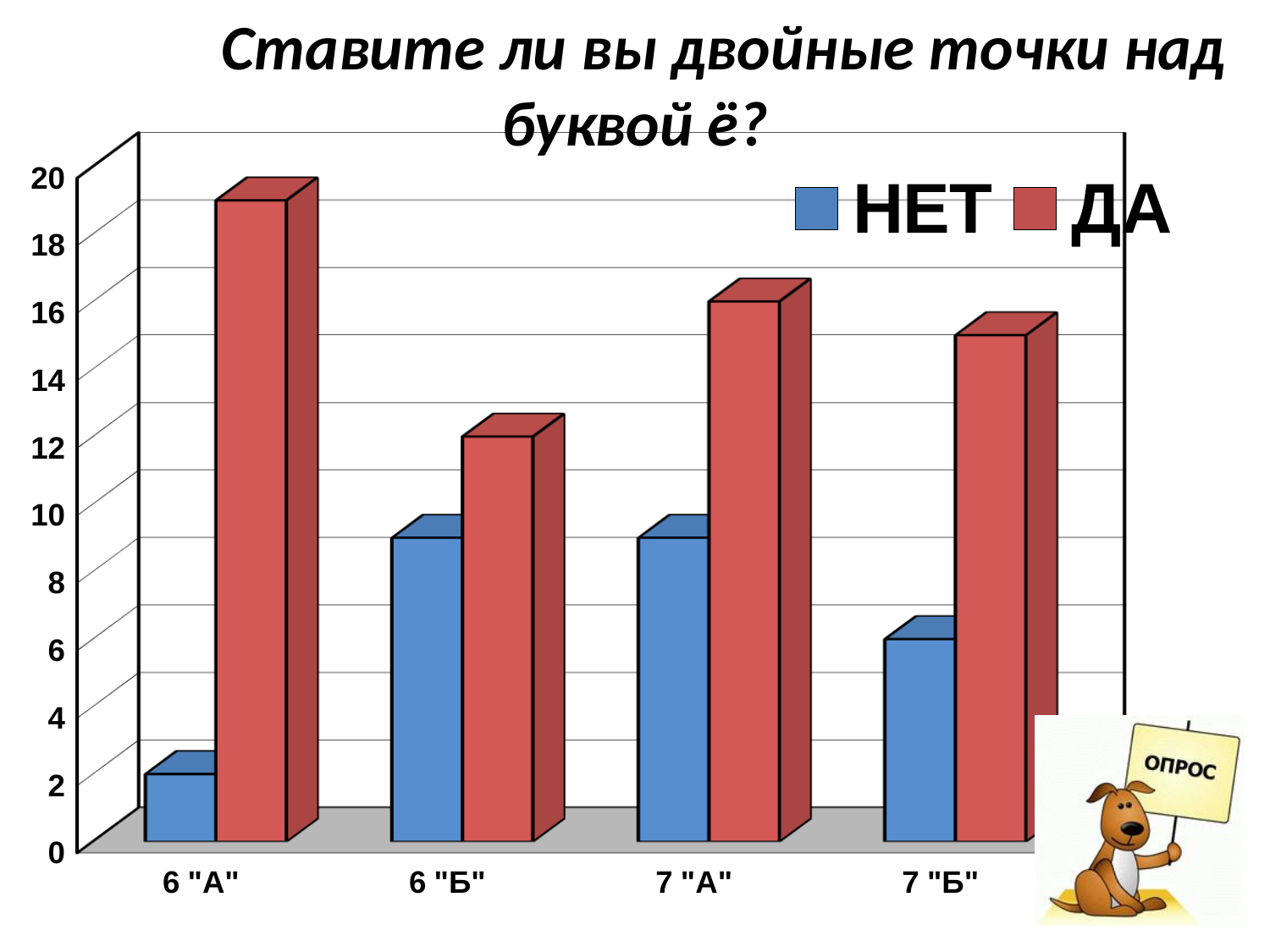
Is the value for НЕТ in 6 "А" greater or less than 4? less Is the value for НЕТ in 7 "Б" greater or less than 8? less Which colour represents the ДА series in the legend? red Is the value for ДА in 6 "А" greater or less than 18? greater How many categories (classes) are shown on the x axis? 4 Which class has the lowest value for ДА? 6 "Б" How many series does the legend list? 2 In 6 "Б", which is larger: the value for НЕТ or the value for ДА? ДА What kind of chart is shown on the slide? bar chart Which class has the highest value for ДА? 6 "А" Which class has the lowest value for НЕТ? 6 "А"